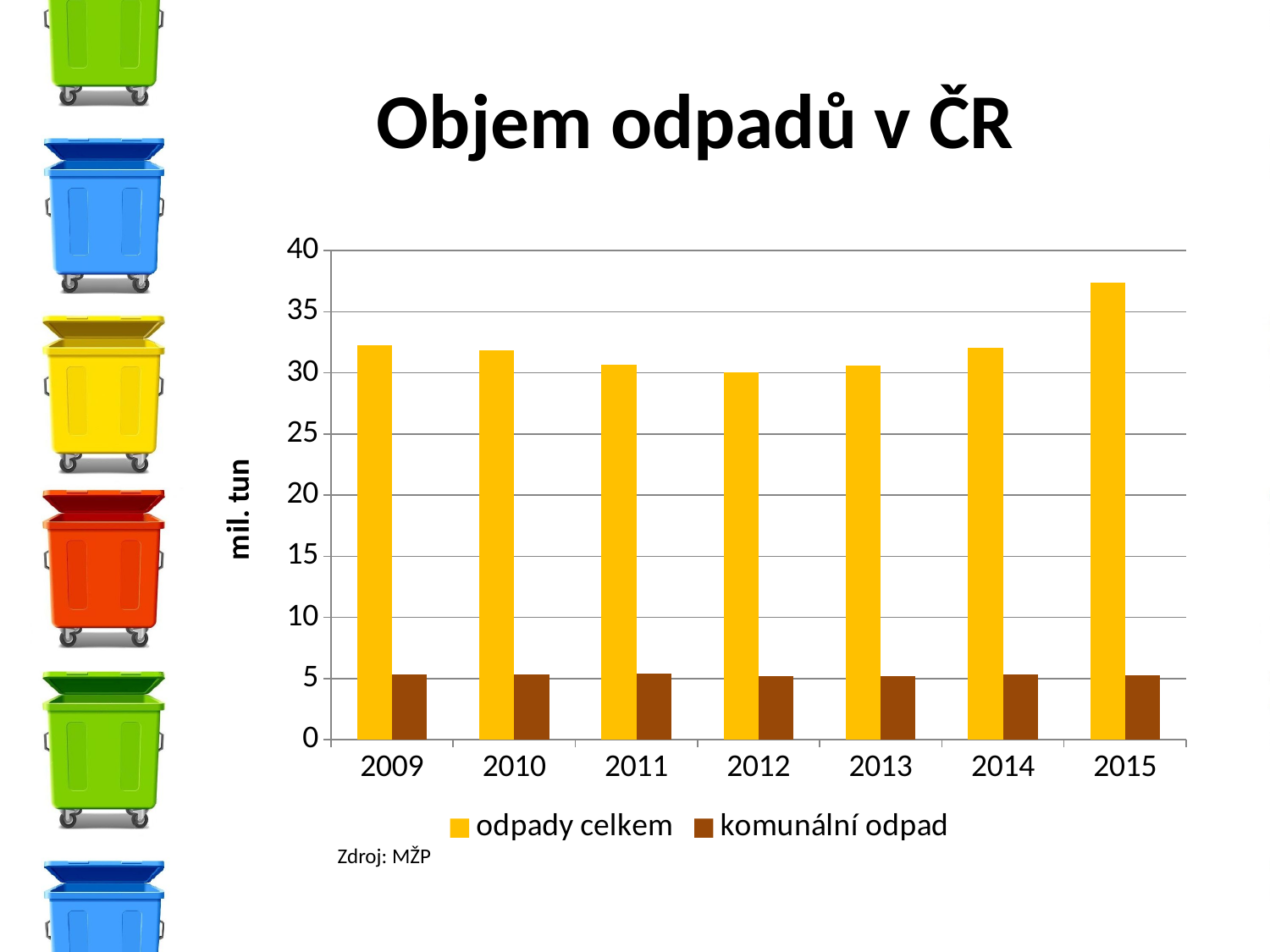
Do the values for odpady celkem rise or fall from 2012 to 2015? rise Is the value for komunální odpad in 2013 greater or less than 10? less What is the label on the y axis? mil. tun Is the value for odpady celkem in 2015 greater or less than 35? greater Is the value for odpady celkem in 2012 greater or less than 35? less How many years are shown on the x axis? 7 Which is larger, the value for odpady celkem in 2009 or in 2011? 2009 What kind of chart is shown on the slide? bar chart In which year is the value for odpady celkem highest? 2015 How many series does the legend list? 2 What is the title of the chart? Objem odpadů v ČR